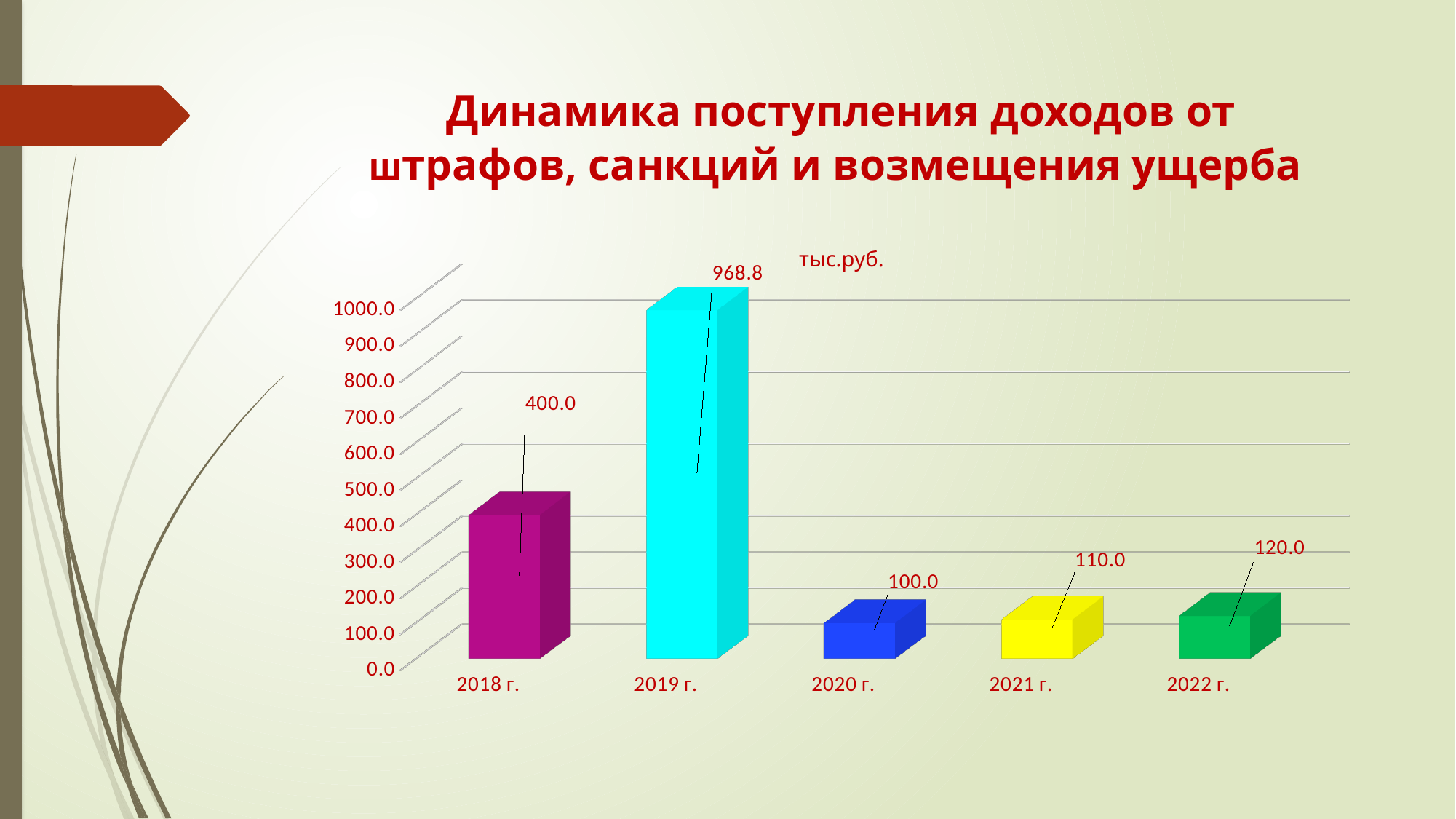
What is the difference between the values for 2022 г. and 2020 г.? 20.0 Is the value for 2019 г. greater or less than 900.0? greater What is the value for 2018 г.? 400.0 What is the difference between the values for 2019 г. and 2018 г.? 568.8 Which is larger, the value for 2018 г. or the value for 2022 г.? 2018 г. What is the value for 2019 г.? 968.8 What is the value for 2021 г.? 110.0 Which year has the lowest value? 2020 г. Which year has the highest value? 2019 г. What kind of chart is shown on the slide? bar chart What unit is indicated above the chart? тыс.руб. How many years are shown on the x axis? 5